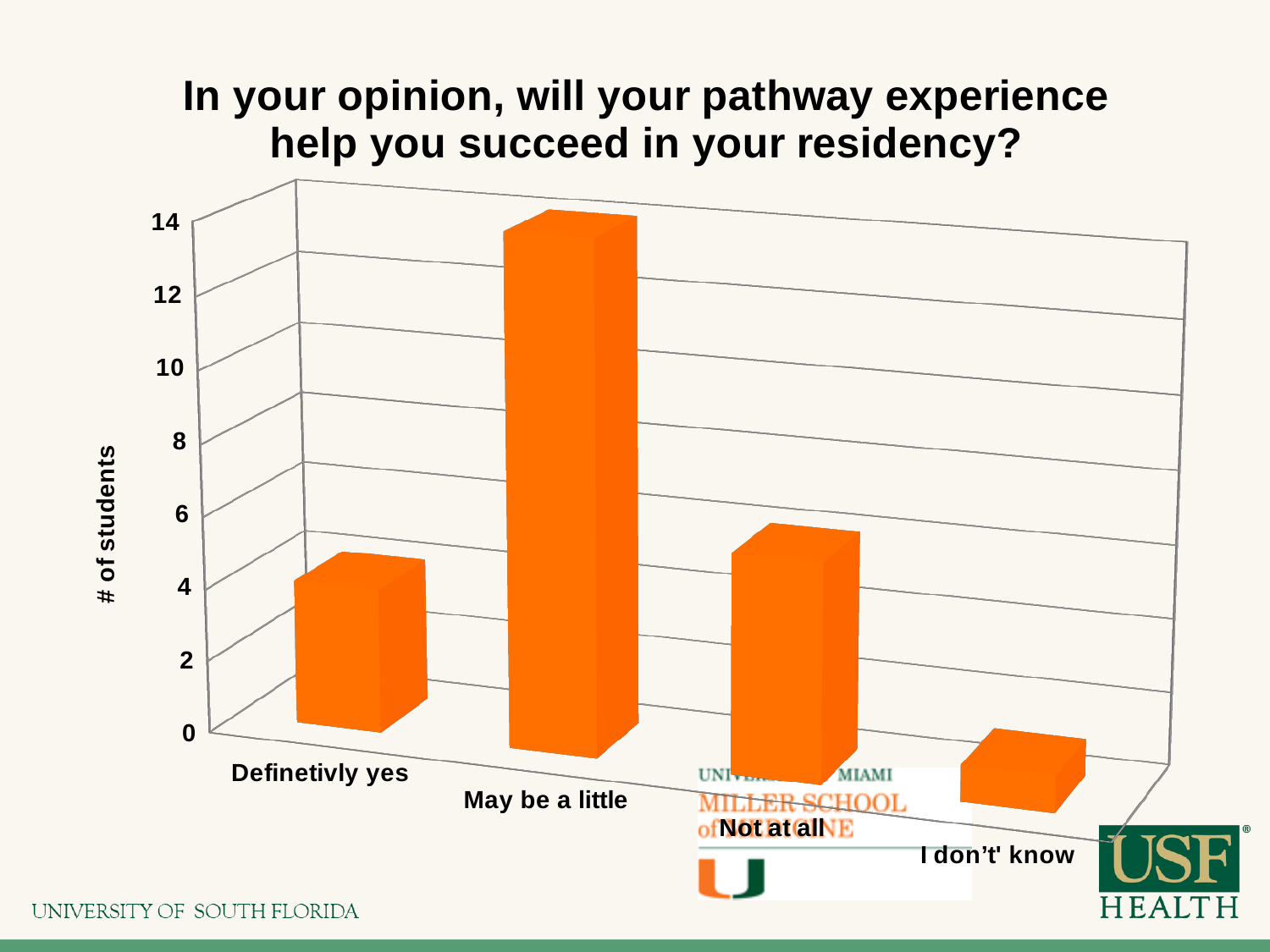
Which category has the highest number of students? May be a little Which is larger, the value for "Definetivly yes" or the value for "I don't' know"? Definetivly yes Is the value for "May be a little" greater or less than 10? greater Is the value for "Not at all" greater or less than 10? less Which is larger, the value for "May be a little" or the value for "Not at all"? May be a little How many categories are shown on the x axis of the chart? 4 What is the title of the vertical axis of the chart? # of students Is the value for "Definetivly yes" greater or less than 8? less What kind of chart is shown on the slide? bar chart What question does the chart title ask? In your opinion, will your pathway experience help you succeed in your residency? Which category has the lowest number of students? I don't' know